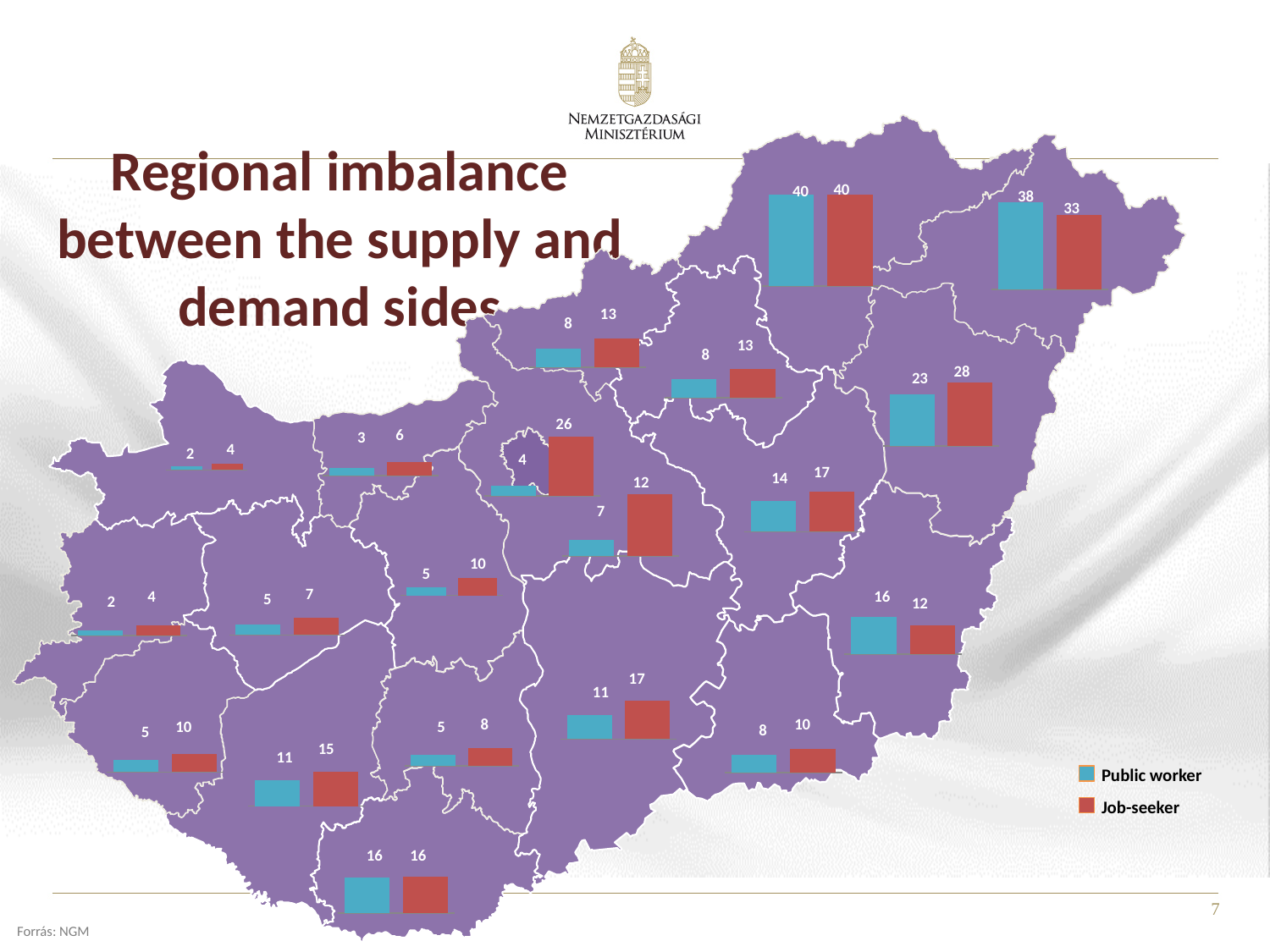
In the chart on the north-eastern county (top right of the map), what is the difference between the Public worker and Job-seeker values? 5 In the chart on the northernmost county (top centre of the map), what is the Job-seeker value? 40 What is the lowest Public worker value shown in any county chart on the map? 2 In the chart on the southernmost county (bottom centre of the map), what is the Public worker value? 16 What is the highest Job-seeker value shown in any county chart on the map? 40 How many series does the legend list? 2 In the chart on the northernmost county (top centre of the map), what is the Public worker value? 40 In the chart on the north-eastern county (top right of the map), which is larger, Public worker or Job-seeker? Public worker What are the two series named in the legend? Public worker and Job-seeker What kind of chart is placed on each county of the map? Bar chart Which colour represents Job-seeker in the legend? Red In the chart on the north-eastern county (top right of the map), what is the Job-seeker value? 33